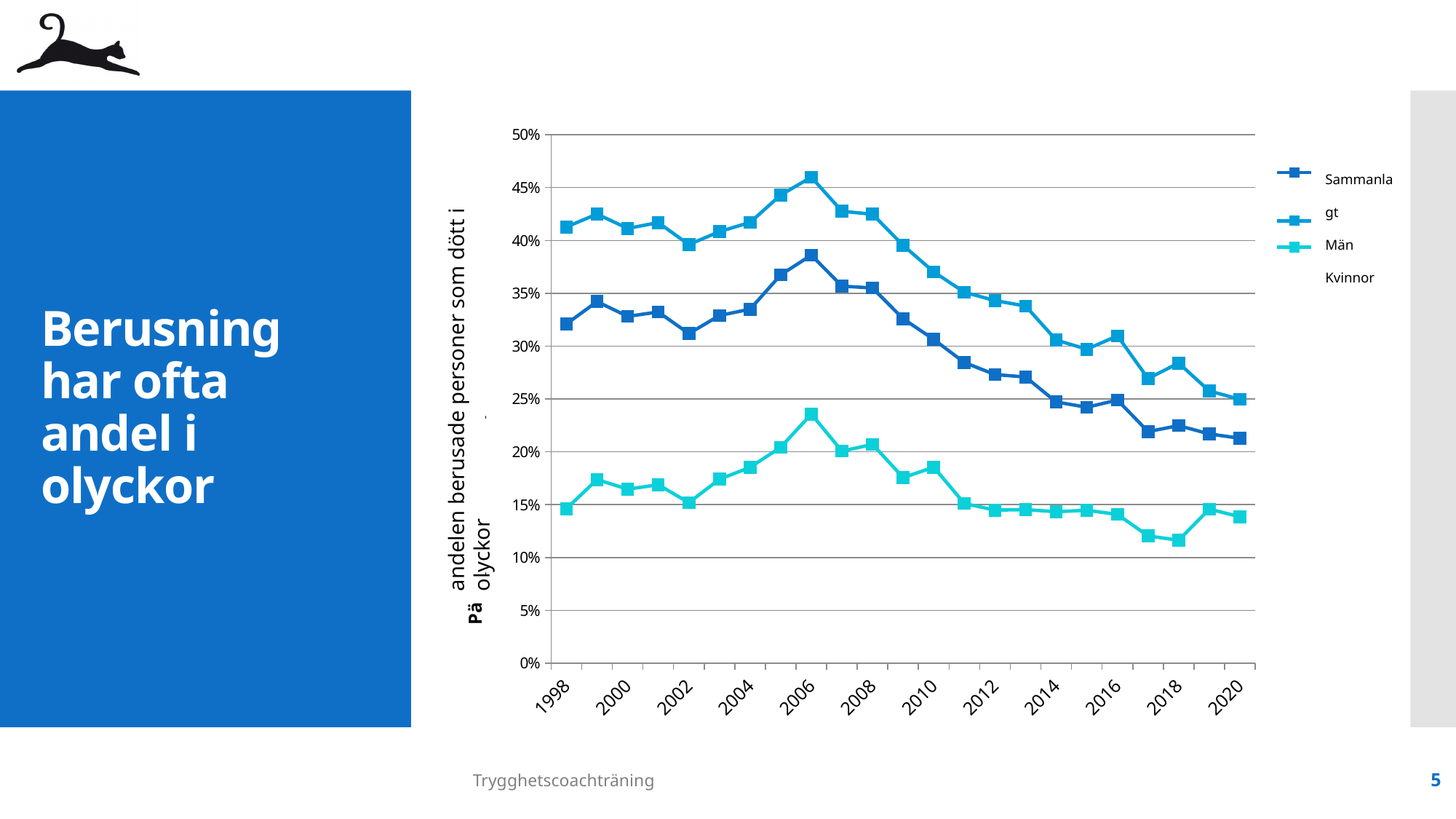
Which series are listed in the chart's legend? Sammanlagt, Män, Kvinnor In which year does the Kvinnor series reach its highest value? 2006 Is the value for Män in 2006 greater or less than 40%? greater Which series has the larger value in 2010, Män or Kvinnor? Män Do the values of the Sammanlagt series rise or fall from 2006 to 2020? fall How many series does the chart's legend list? 3 Is the value for Kvinnor in 2006 greater or less than 20%? greater Is the value for Sammanlagt in 2020 greater or less than 25%? less In which year does the Män series reach its highest value? 2006 What kind of chart is shown on the slide? line chart How many year labels are shown on the x axis of the chart? 12